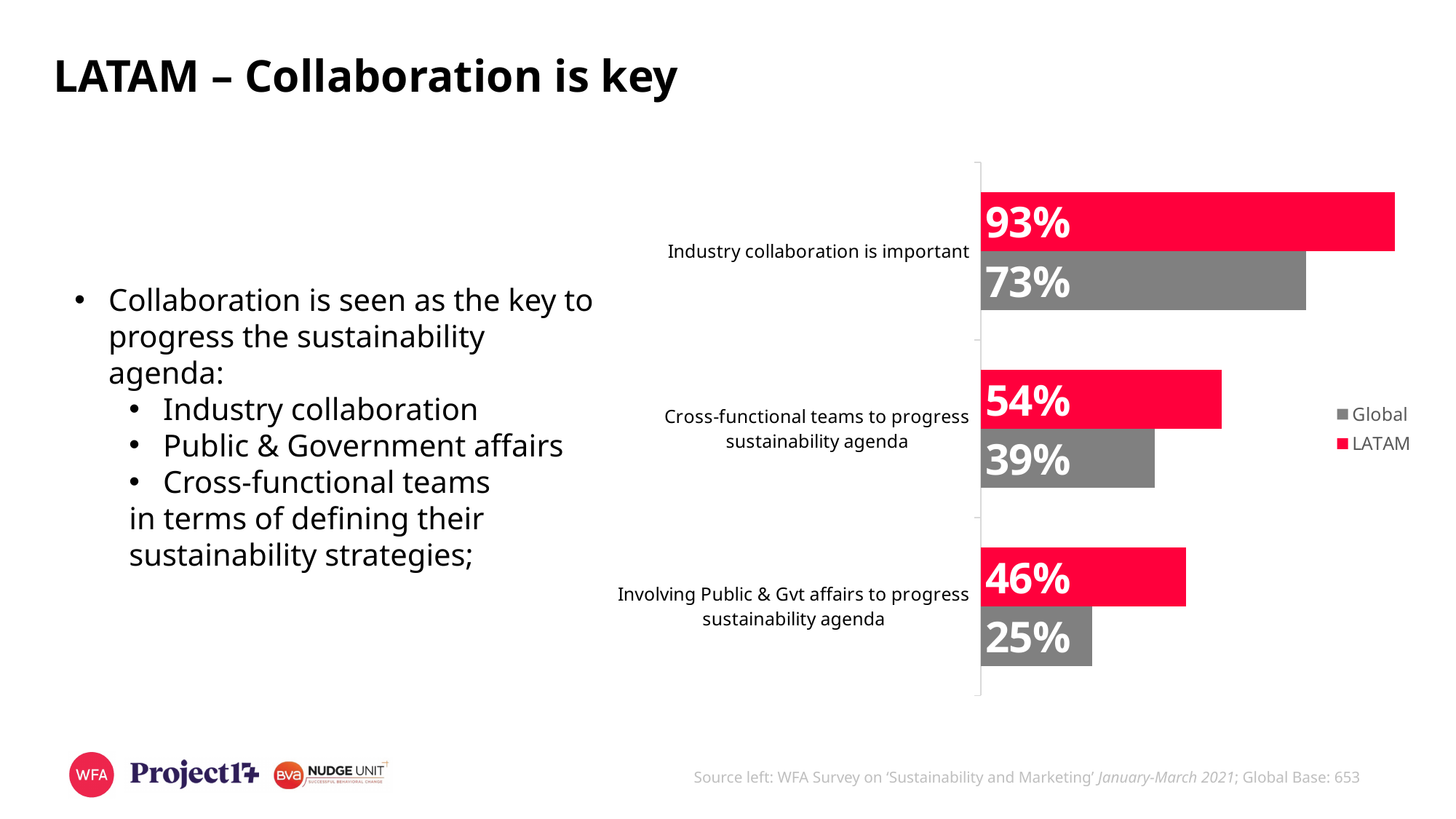
What is the LATAM value for 'Involving Public & Gvt affairs to progress sustainability agenda'? 46% What is the Global value for 'Cross-functional teams to progress sustainability agenda'? 39% What is the Global value for 'Industry collaboration is important'? 73% How many series does the legend list? 2 What is the LATAM value for 'Industry collaboration is important'? 93% What is the difference between the LATAM and Global values for 'Involving Public & Gvt affairs to progress sustainability agenda'? 21% How many categories are shown in the chart? 3 Which category has the lowest Global value? Involving Public & Gvt affairs to progress sustainability agenda What is the difference between the LATAM and Global values for 'Industry collaboration is important'? 20% For 'Cross-functional teams to progress sustainability agenda', which is larger: the LATAM value or the Global value? LATAM What kind of chart is shown on the slide? Bar chart Which category has the highest LATAM value? Industry collaboration is important